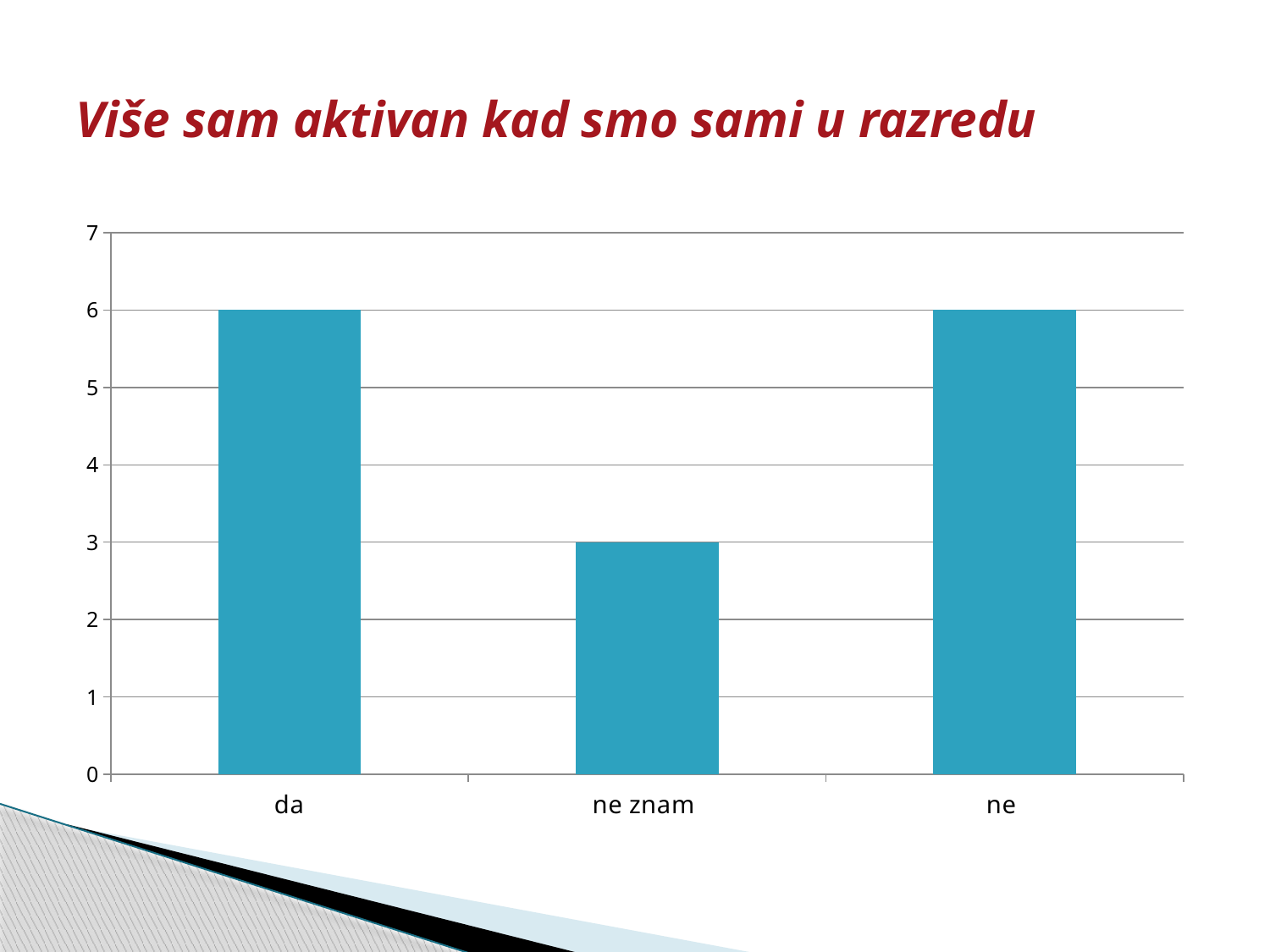
What is the highest value shown on the vertical axis? 7 Which category has the lowest value? ne znam Is the value for "da" greater or less than 4? greater What kind of chart is shown on the slide? bar chart What is the title of the slide? Više sam aktivan kad smo sami u razredu How many categories are shown on the x axis? 3 What is the value for "ne"? 6 Which is larger, the value for "ne" or the value for "ne znam"? ne What is the value for "da"? 6 Is the value for "ne znam" greater or less than 5? less What is the value for "ne znam"? 3 What is the difference between the values for "da" and "ne znam"? 3